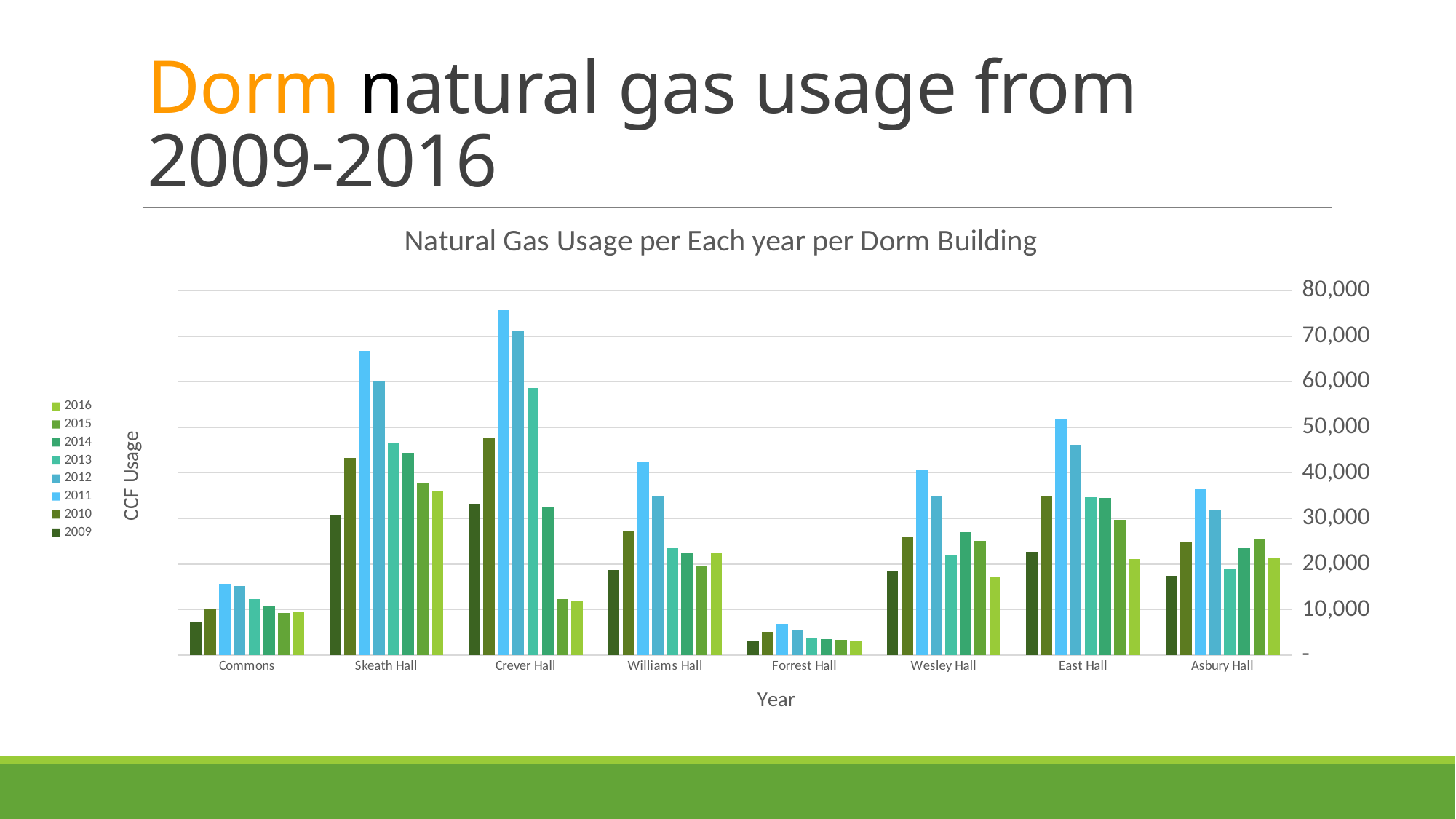
For Crever Hall, which year has the highest natural gas usage? 2011 Is the 2011 value for Skeath Hall greater or less than 60,000? greater Which dorm building has the lowest natural gas usage across all years? Forrest Hall Is the 2011 value for Forrest Hall greater or less than 10,000? less What is the label on the vertical axis of the chart? CCF Usage How many dorm buildings are shown along the x axis of the chart? 8 Which is larger: the 2016 value for Skeath Hall or the 2016 value for Crever Hall? Skeath Hall Is the 2011 value for Crever Hall greater or less than 70,000? greater What kind of chart is shown on the slide? Bar chart For Asbury Hall, which year has the highest natural gas usage? 2011 How many series (years) does the chart legend list? 8 Which dorm building has the single highest bar in the chart? Crever Hall